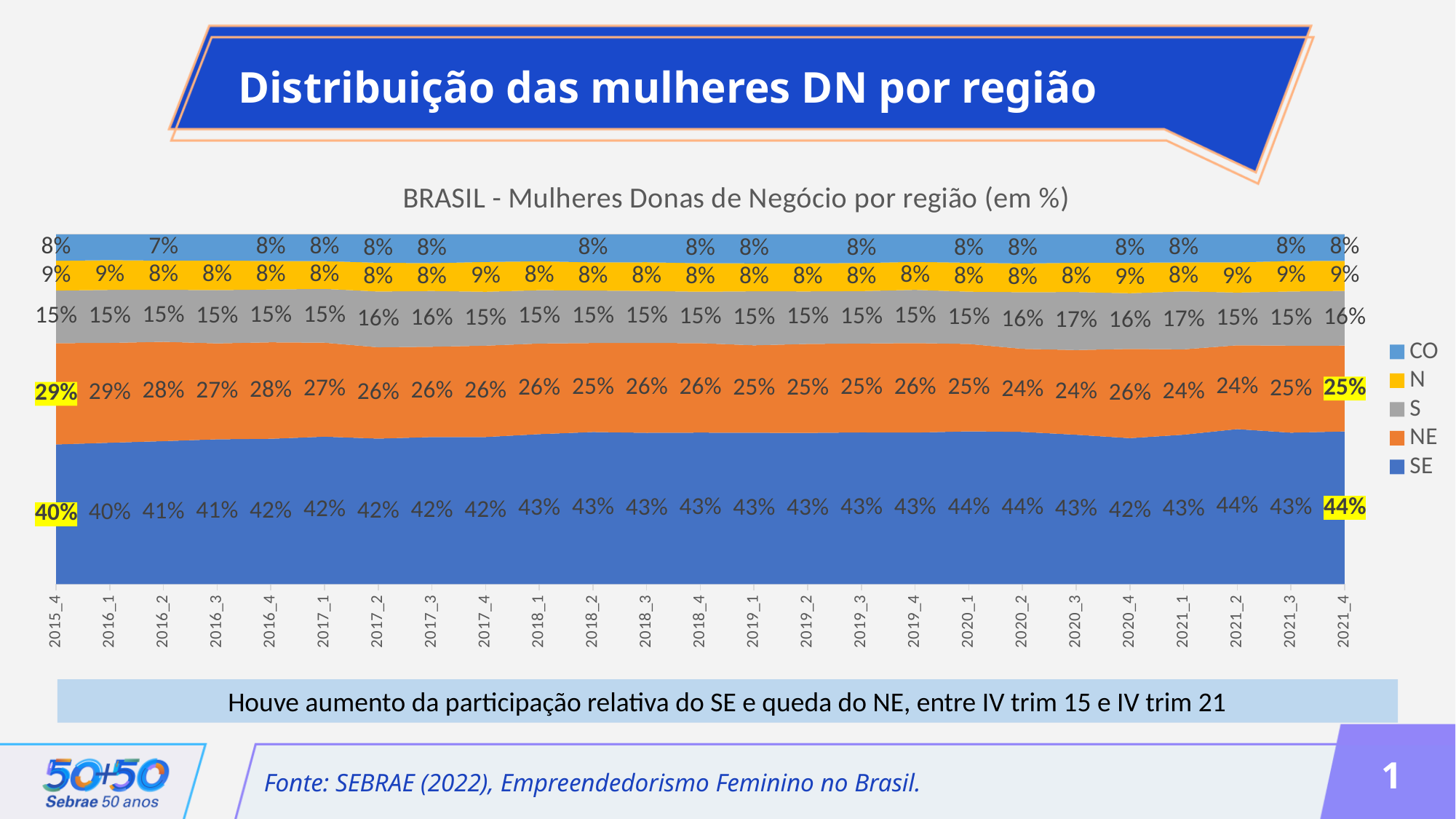
What is the value for NE in 2015_4? 29% Does the SE series rise or fall from 2015_4 to 2021_4? Rise How many series does the legend list? 5 By how many percentage points did the SE value change between 2015_4 and 2021_4? 4 percentage points What is the value for NE in 2021_4? 25% Does the NE series rise or fall from 2015_4 to 2021_4? Fall What is the value for SE in 2015_4? 40% What is the value for SE in 2021_4? 44% How many quarters are shown on the x axis? 25 What kind of chart is shown on the slide? Stacked area chart What is the title of the chart? BRASIL - Mulheres Donas de Negócio por região (em %) What is the value for S in 2020_3? 17%